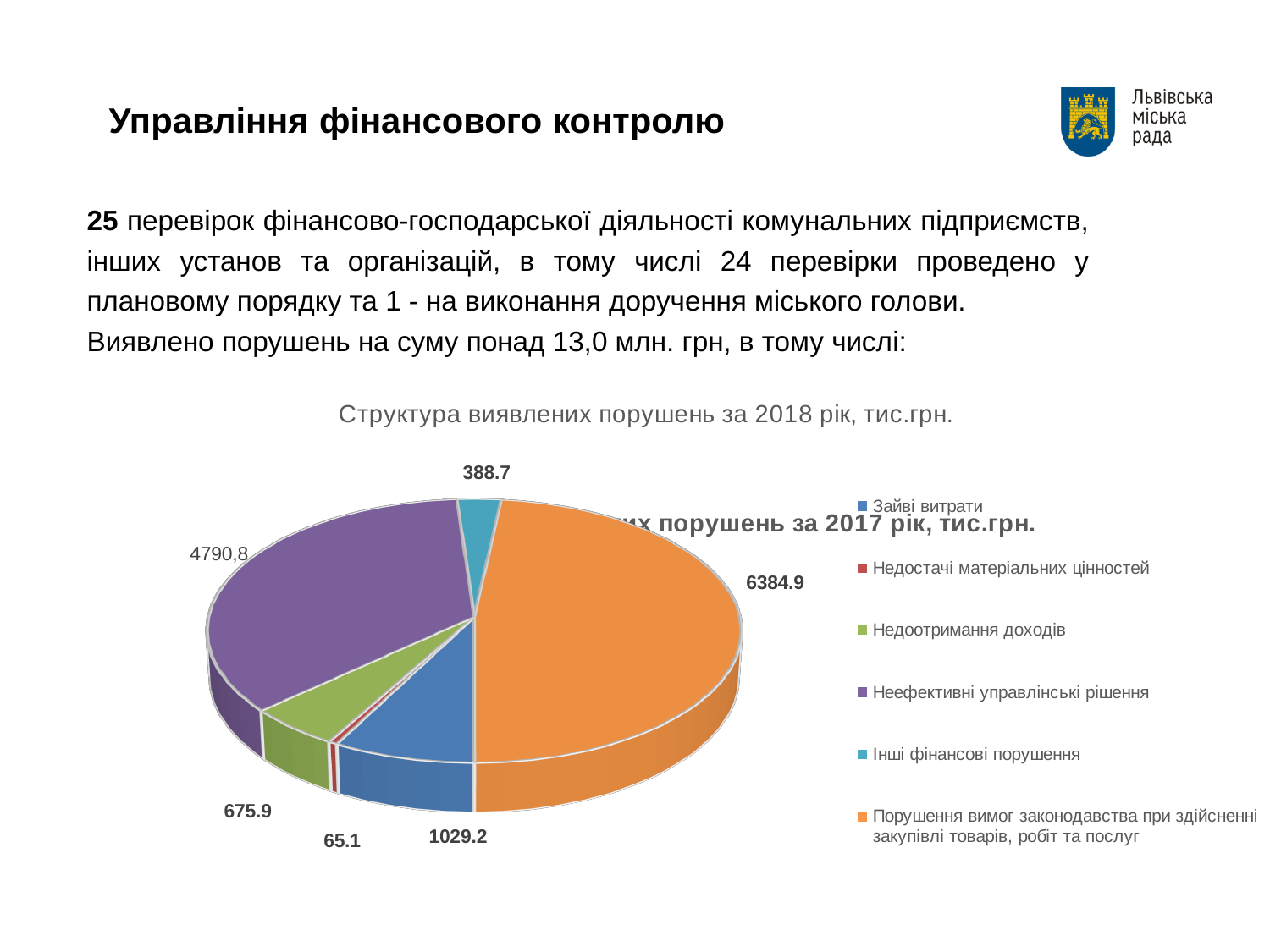
What is the value for 'Недостачі матеріальних цінностей'? 65.1 What is the title of the pie chart? Структура виявлених порушень за 2018 рік, тис.грн. Which category has the smallest slice of the pie? Недостачі матеріальних цінностей Which category has the largest slice of the pie? Порушення вимог законодавства при здійсненні закупівлі товарів, робіт та послуг What is the value for 'Зайві витрати'? 1029.2 Which is larger: 'Недоотримання доходів' or 'Інші фінансові порушення'? Недоотримання доходів What is the difference between 'Зайві витрати' and 'Недоотримання доходів'? 353.3 What is the value for 'Порушення вимог законодавства при здійсненні закупівлі товарів, робіт та послуг'? 6384.9 How many categories does the legend of the pie chart list? 6 What kind of chart is shown on the slide? Pie chart What is the value for 'Інші фінансові порушення'? 388.7 What is the value for 'Неефективні управлінські рішення'? 4790,8